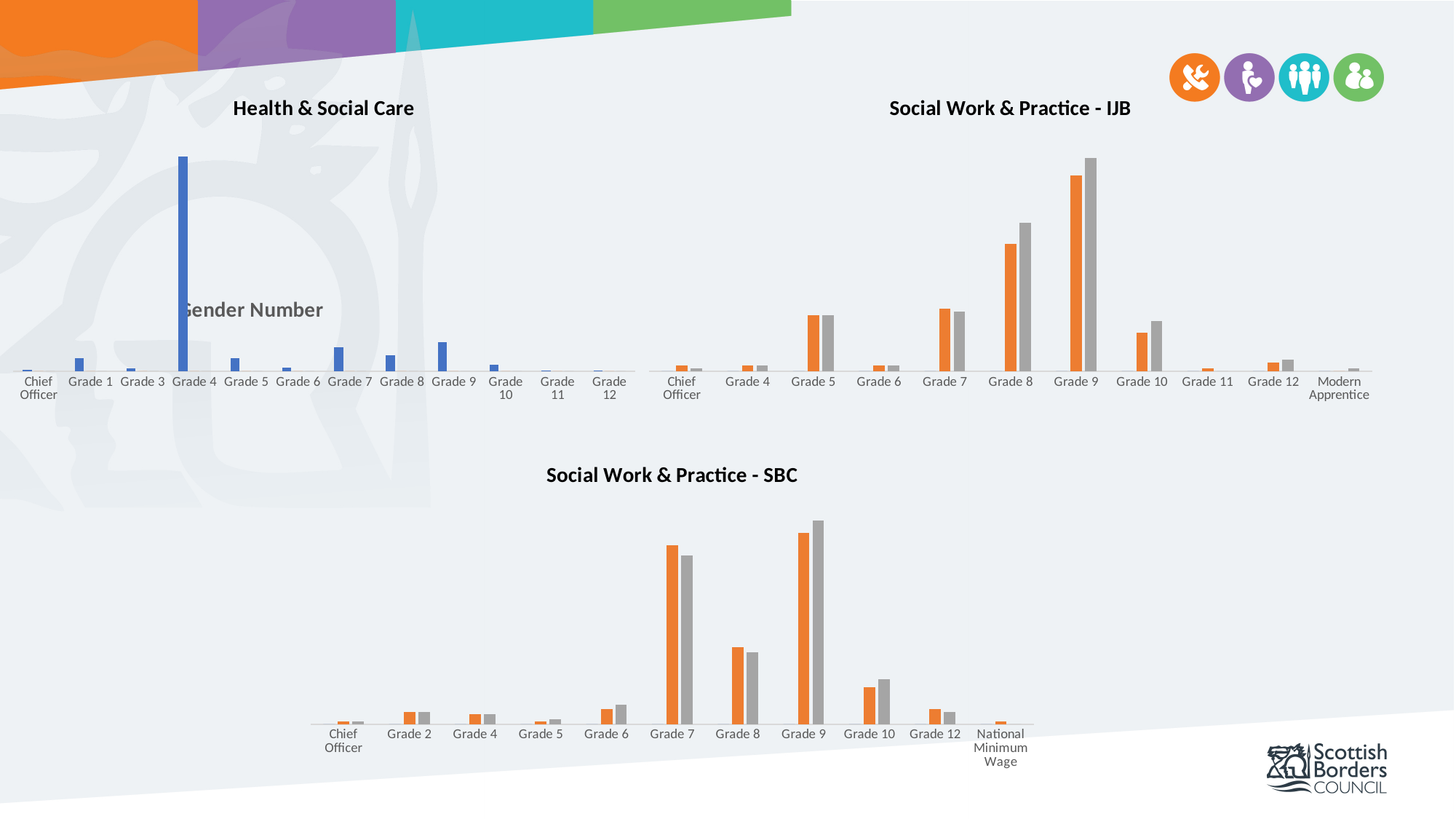
In the 'Health & Social Care' chart, which is larger, the value for Grade 9 or the value for Grade 5? Grade 9 In the 'Social Work & Practice - SBC' chart, which category has the tallest bar? Grade 9 In the 'Social Work & Practice - SBC' chart, which is larger, the orange bar for Grade 7 or the orange bar for Grade 8? Grade 7 How many categories are shown on the x axis of the 'Health & Social Care' chart? 12 What is the title of the chart at the bottom of the slide? Social Work & Practice - SBC In the 'Health & Social Care' chart, which category has the highest value? Grade 4 In the 'Social Work & Practice - IJB' chart, which category has the tallest bars? Grade 9 In the 'Social Work & Practice - IJB' chart, which is larger, the orange bar for Grade 5 or the orange bar for Grade 10? Grade 5 How many categories are shown on the x axis of the 'Social Work & Practice - SBC' chart? 11 What type of chart is the 'Health & Social Care' chart? bar chart How many categories are shown on the x axis of the 'Social Work & Practice - IJB' chart? 11